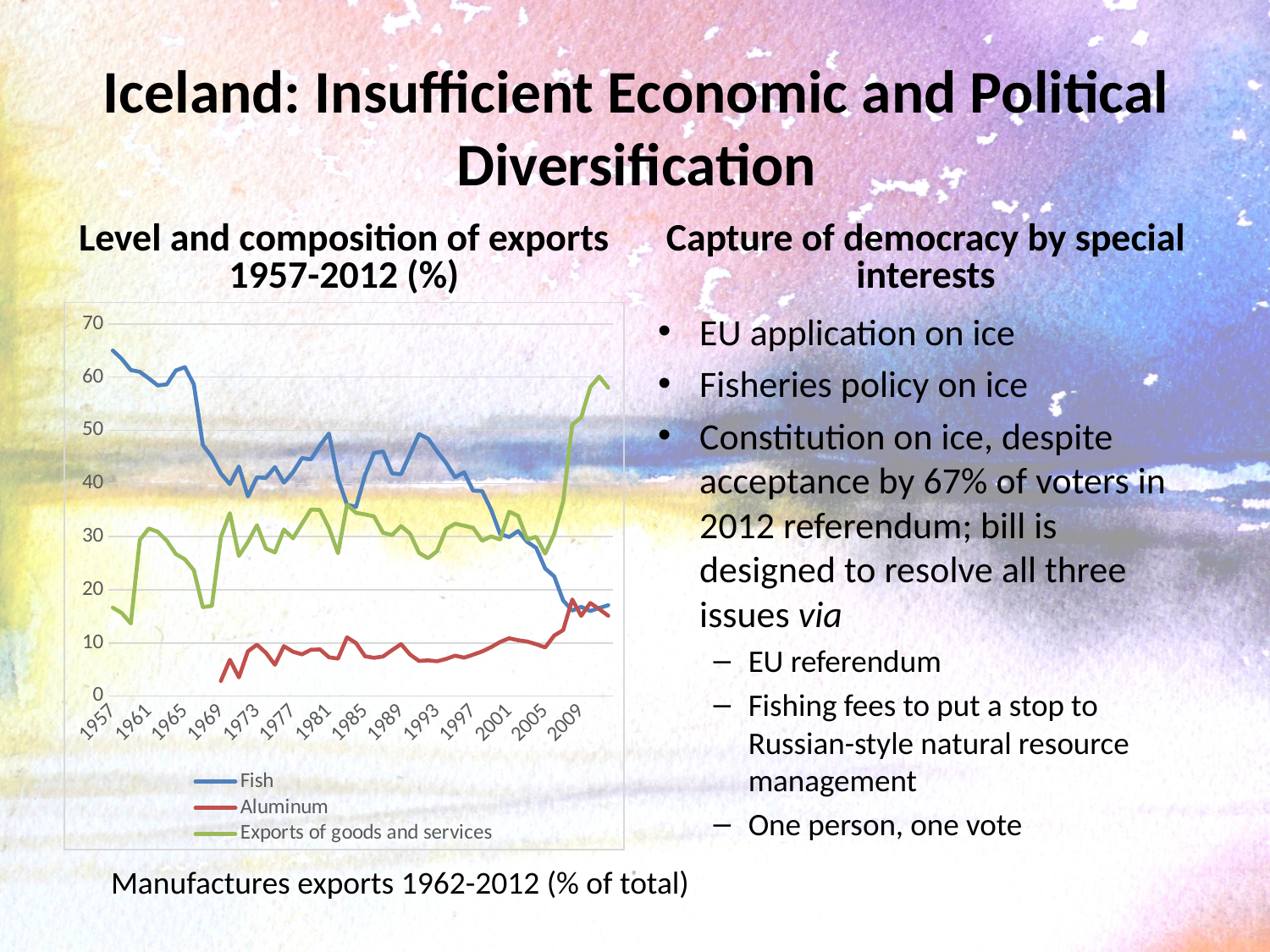
Which series is shown by the green line in the chart? Exports of goods and services Is the value for Exports of goods and services in 2009 greater or less than 40? greater Is the value for Aluminum in 1985 greater or less than 20? less Does the Aluminum series generally rise or fall from 1969 to 2012? rise Does the Fish series generally rise or fall from 1957 to 2012? fall What kind of chart is shown on the slide? line chart How many series does the chart's legend list? 3 Is the value for Fish in 2009 greater or less than 30? less Which series has the highest value in 1957? Fish What is the title of the chart? Level and composition of exports 1957-2012 (%) Which series has the lowest value in 1985? Aluminum